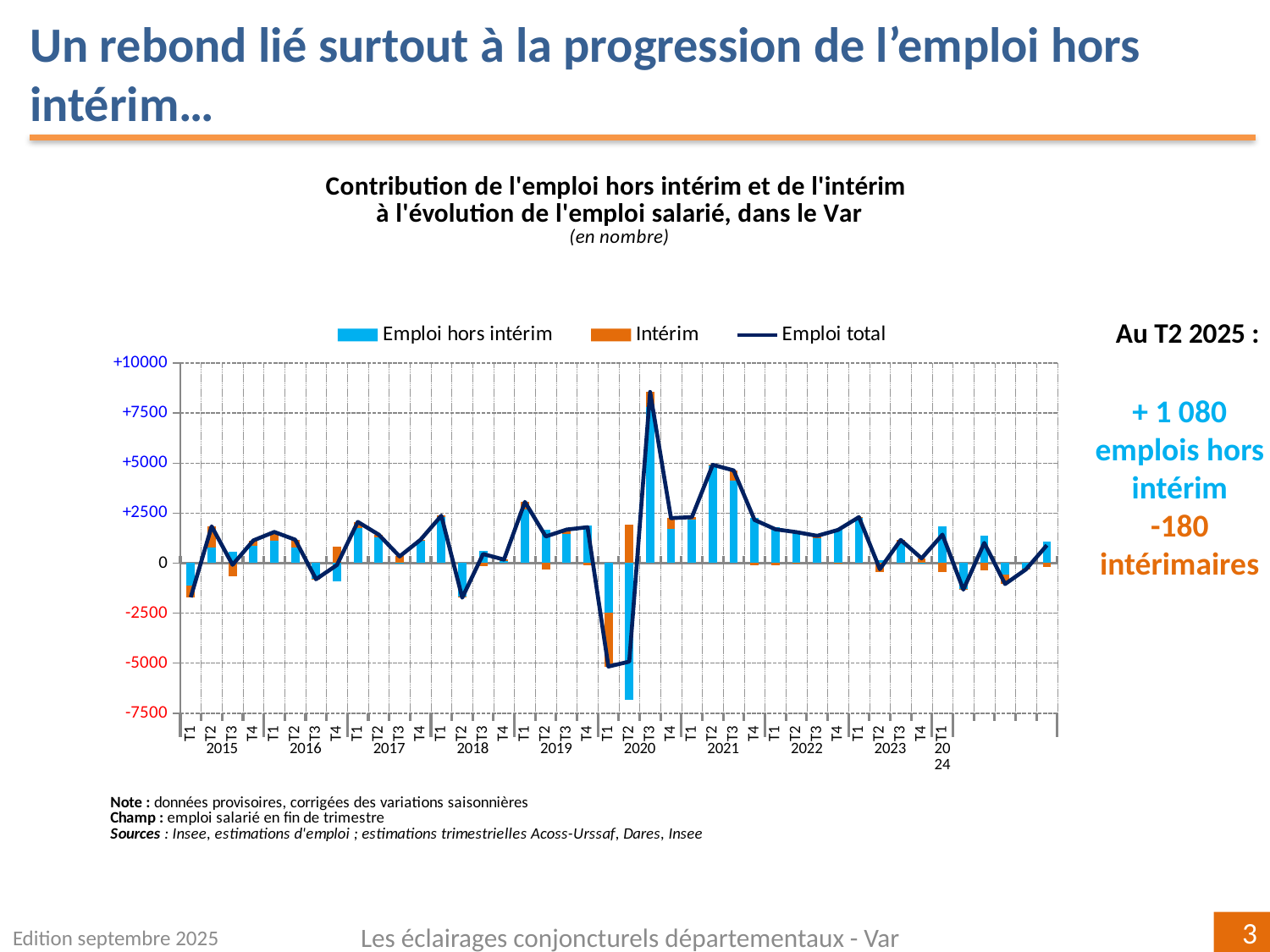
Is the Emploi total value at T3 2020 greater or less than 7500? greater In which quarter does the Emploi total line reach its highest value? T3 2020 Is the Emploi hors intérim value at T2 2020 greater or less than -5000? less In which quarter is the Emploi hors intérim bar at its lowest? T2 2020 What kind of chart is shown on the slide? A bar chart combined with a line What is the title of the chart? Contribution de l'emploi hors intérim et de l'intérim à l'évolution de l'emploi salarié, dans le Var Which is larger, the Emploi total value at T2 2021 or at T2 2022? T2 2021 According to the slide, what is the value for Emploi hors intérim at T2 2025? + 1 080 Does the Emploi total line rise or fall from T1 2020 to T3 2020? rise What are the three series listed in the chart legend? Emploi hors intérim, Intérim, Emploi total According to the slide, what is the value for Intérim at T2 2025? -180 How many series does the chart legend list? 3